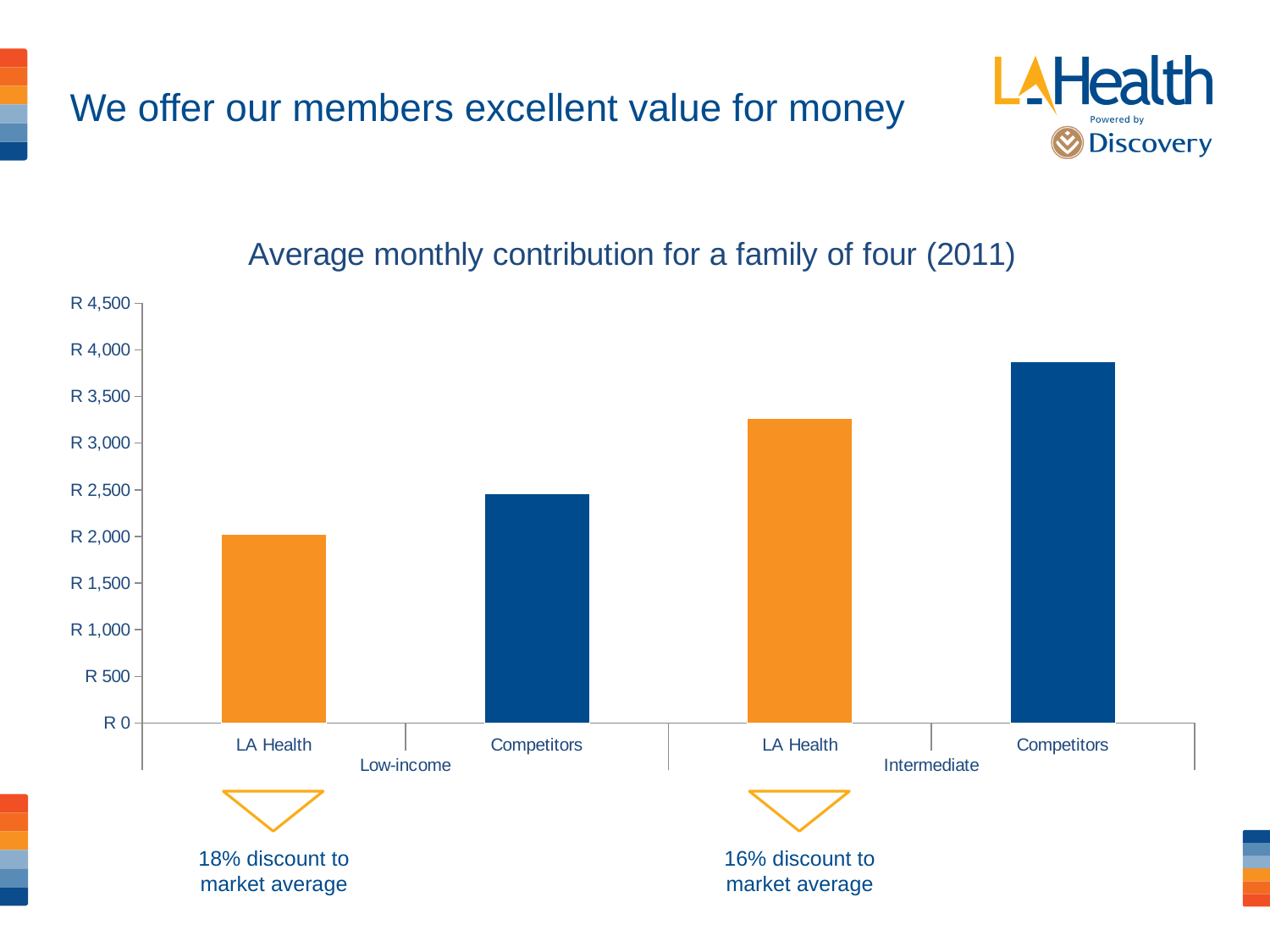
In the Low-income group, which is larger: LA Health or Competitors? Competitors In the Intermediate group, which is larger: LA Health or Competitors? Competitors What is the title of the chart? Average monthly contribution for a family of four (2011) Is the value for Competitors in the Low-income group greater or less than R 2,000? greater Is the value for LA Health in the Intermediate group greater or less than R 3,000? greater Do the bar values rise or fall from left to right across the chart? rise Which bar has the lowest value? LA Health (Low-income) What kind of chart is shown on the slide? bar chart Is the value for Competitors in the Intermediate group greater or less than R 4,000? less How many bars are plotted in the chart? 4 Which bar has the highest value? Competitors (Intermediate)